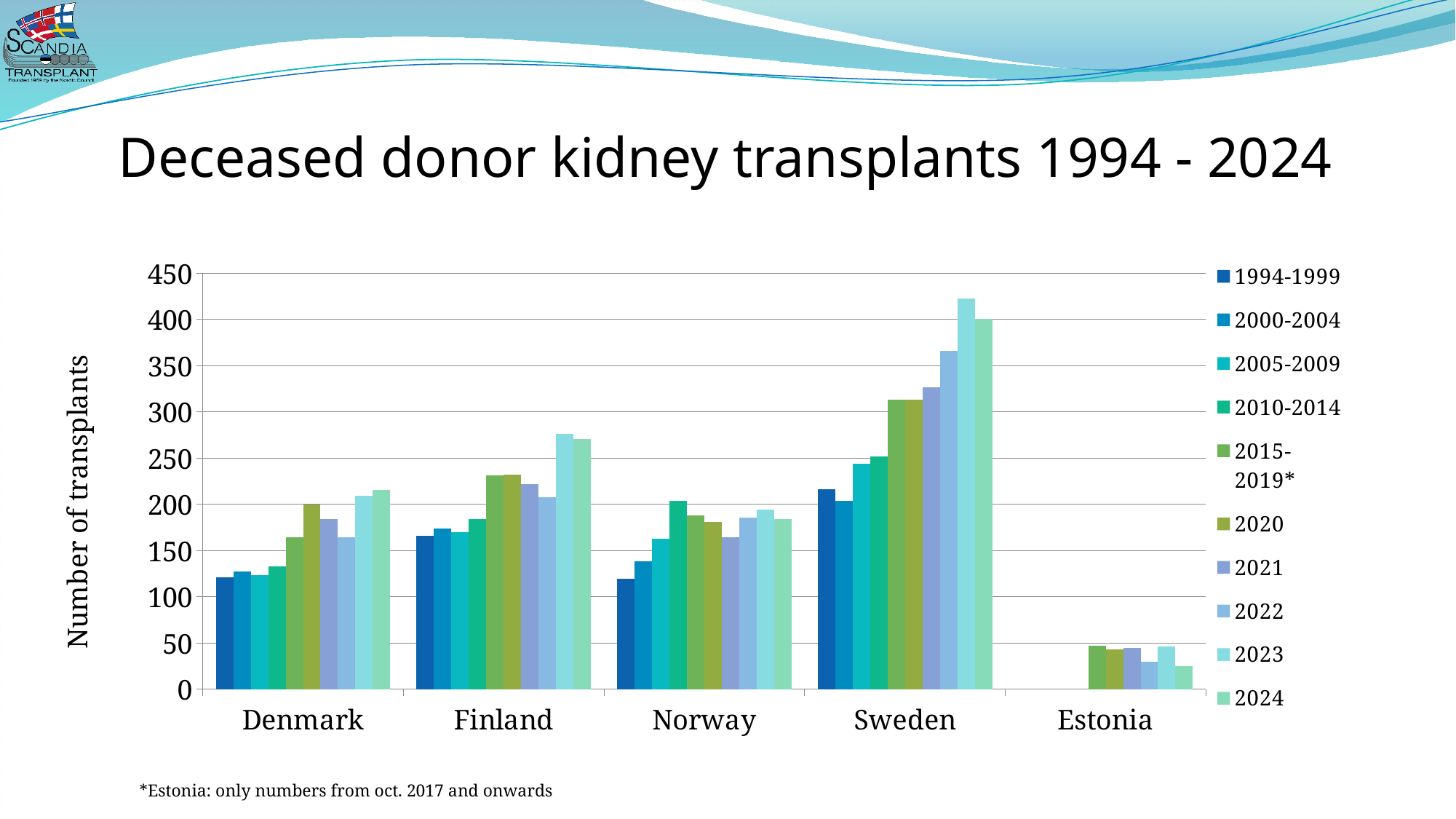
Which country has the lowest bar for 2024? Estonia Is the value for Denmark in 1994-1999 greater or less than 150? less For Sweden, which is larger: the 2023 bar or the 2024 bar? 2023 How many series does the legend list? 10 What is the label on the y axis? Number of transplants Do Sweden's values rise or fall from 2020 through 2023? rise Is the value for Finland in 2020 greater or less than 200? greater How many countries are shown on the x axis? 5 Is the value for Sweden in 2023 greater or less than 400? greater What kind of chart is shown on the slide? Bar chart Which country has the highest bar for 2023? Sweden Which is larger for 2023: Finland or Norway? Finland